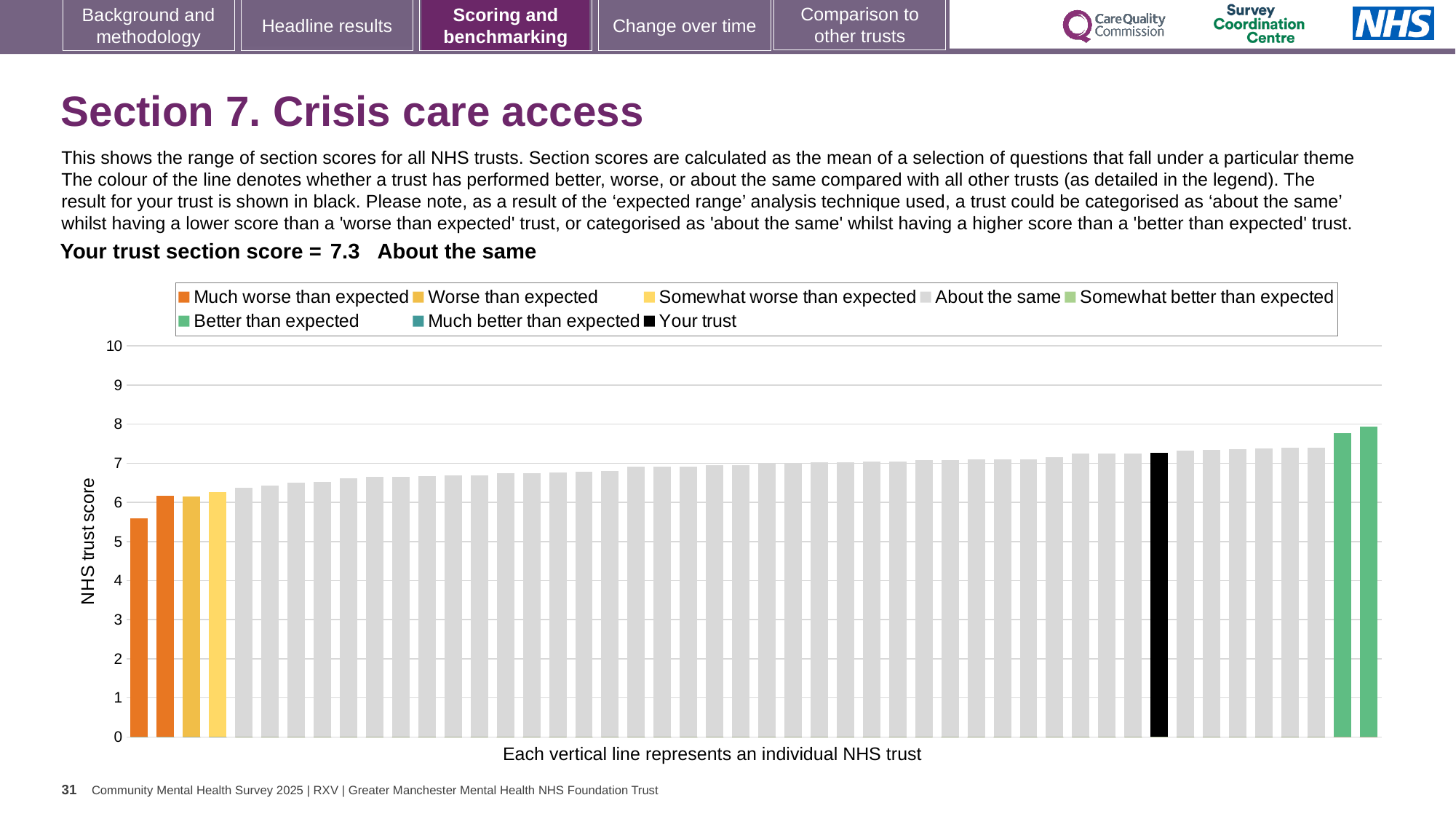
Is the value of the tallest bar greater or less than 7? greater Do the bar values rise or fall from left to right along the x axis? rise What colour is the bar representing your trust? black Is the value of the lowest bar greater or less than 6? less What is the label on the vertical axis of the chart? NHS trust score How many bars are coloured orange (Much worse than expected)? 2 Which legend category do the two tallest bars belong to? Better than expected How many entries does the chart legend list? 8 What kind of chart is shown on the slide? bar chart Is the black bar for your trust higher or lower than the first orange bar on the left? higher Is the value for your trust (black bar) greater or less than 7? greater What is the section score for your trust? 7.3